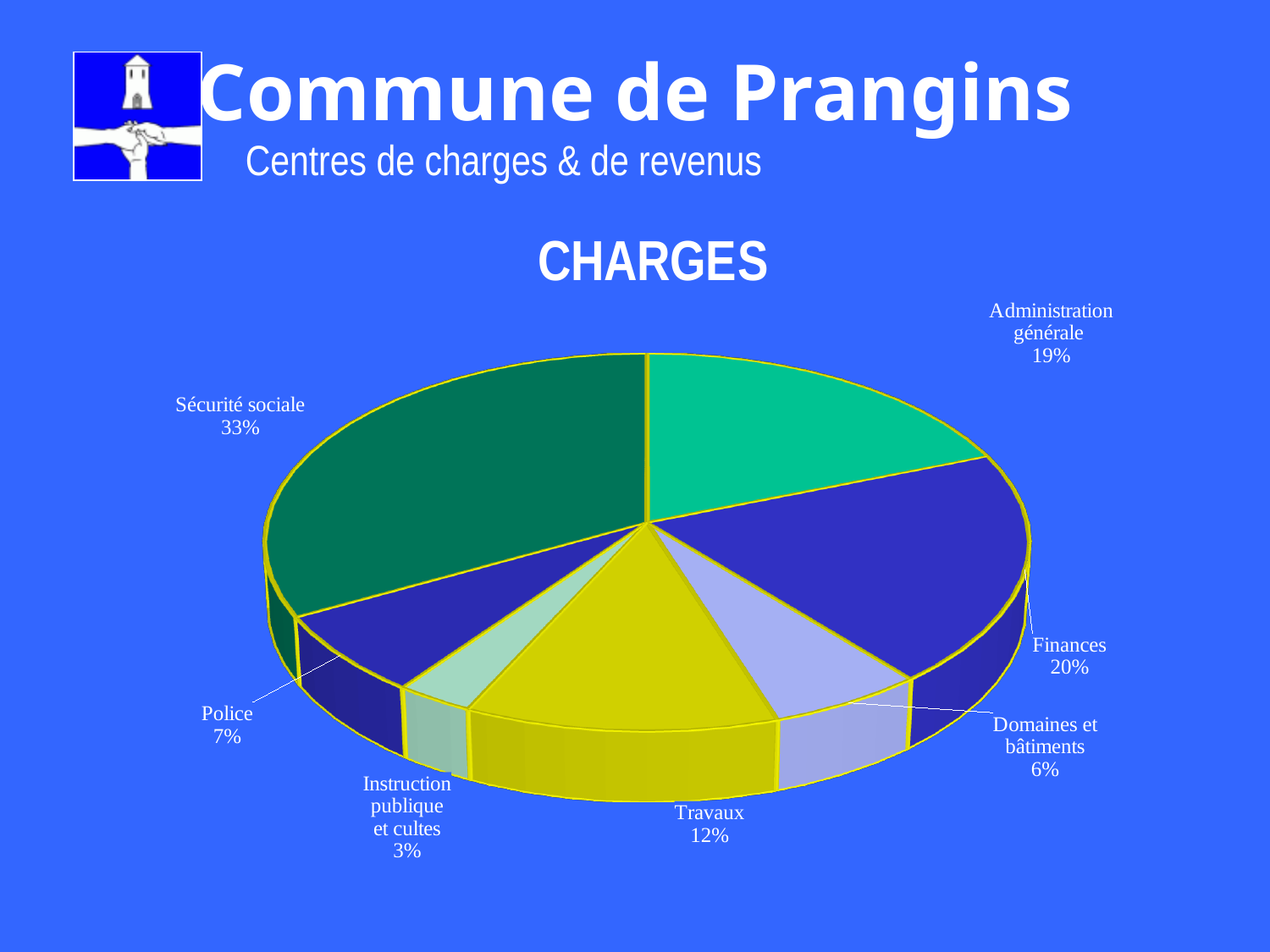
What is the title of the chart? CHARGES What is the difference in percentage points between Sécurité sociale and Finances? 13 What share of the CHARGES pie is Instruction publique et cultes? 3% What share of the CHARGES pie is Sécurité sociale? 33% What share of the CHARGES pie is Finances? 20% What kind of chart is shown on the slide? Pie chart Which category has the smallest slice of the CHARGES pie? Instruction publique et cultes How many categories are shown in the CHARGES pie chart? 7 Which is larger, the share for Police or the share for Domaines et bâtiments? Police Which category has the largest slice of the CHARGES pie? Sécurité sociale